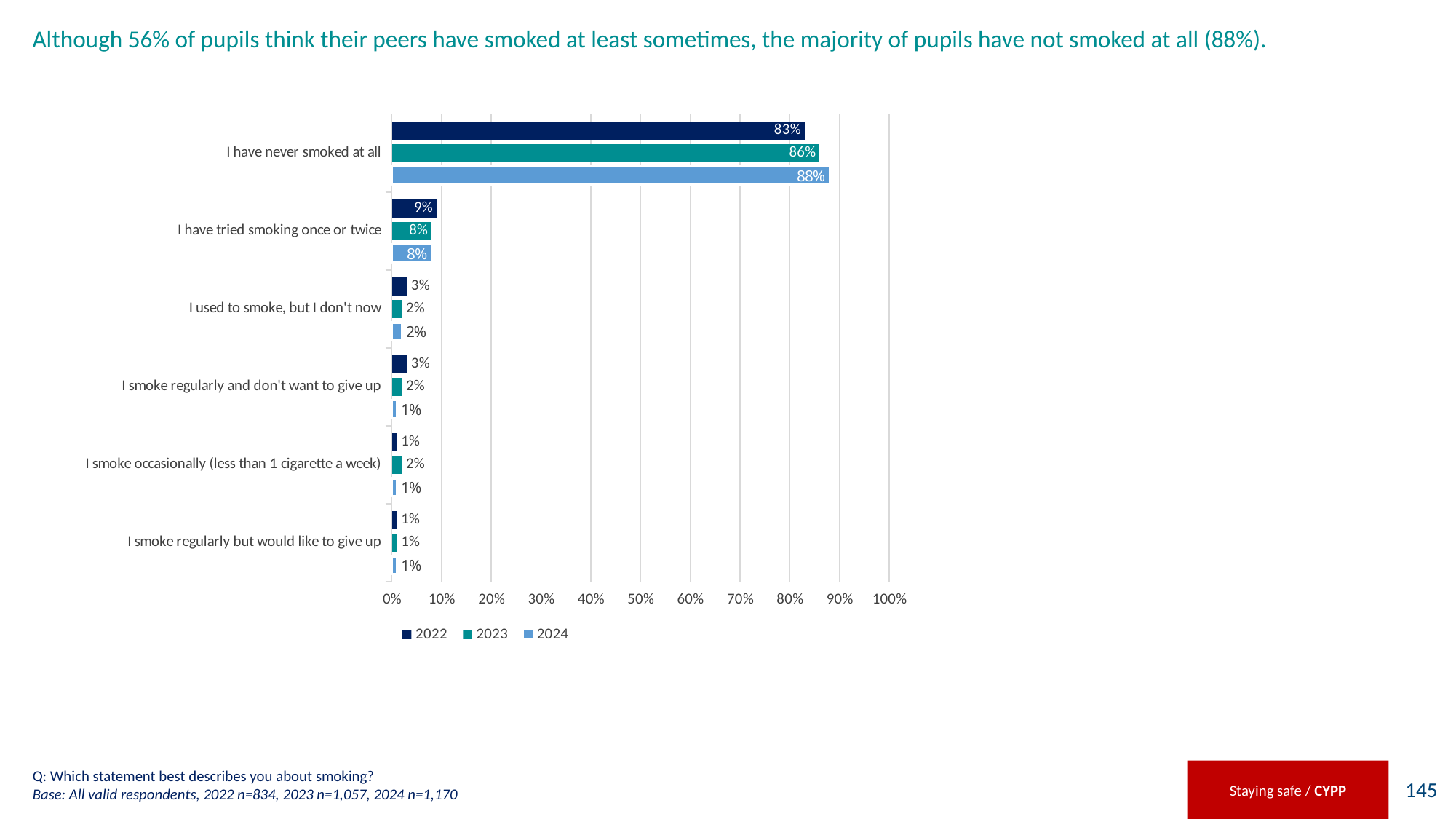
Which years are listed in the chart legend? 2022, 2023, 2024 What percentage of pupils said 'I have tried smoking once or twice' in 2022? 9% Which statement has the highest value in 2024? I have never smoked at all What is the difference between the 2024 and 2022 values for 'I have never smoked at all'? 5% How many series does the legend list? 3 How many statements (categories) are shown on the chart? 6 What is the 2023 value for 'I used to smoke, but I don't now'? 2% Is the 2023 value for 'I have never smoked at all' greater or less than 80%? greater What kind of chart is shown on the slide? Bar chart What is the 2024 value for 'I smoke regularly and don't want to give up'? 1% Which is larger for 'I have tried smoking once or twice': the 2022 value or the 2023 value? 2022 What percentage of pupils said 'I have never smoked at all' in 2024? 88%